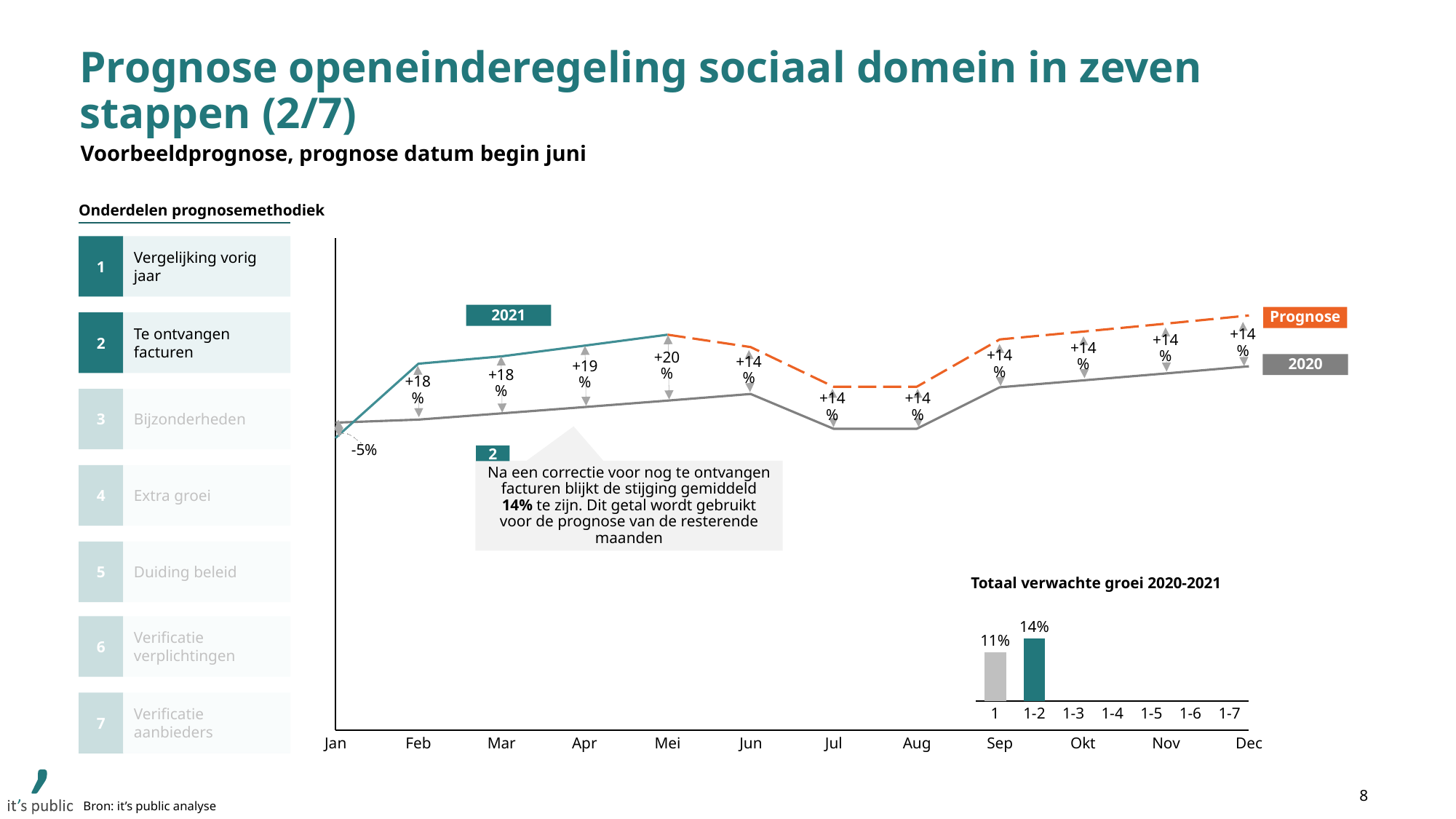
In the line chart, is the labelled percentage difference for Feb larger or smaller than for Mei? smaller In the chart titled 'Totaal verwachte groei 2020-2021', what is the value for category 1-2? 14% In the chart titled 'Totaal verwachte groei 2020-2021', what is the value for category 1? 11% In the line chart, how many months are shown on the x axis? 12 In the line chart, what are the three series labels shown? 2021, Prognose, 2020 In the line chart, which month has the lowest labelled percentage difference? Jan In the chart titled 'Totaal verwachte groei 2020-2021', what is the difference between the values for 1-2 and 1? 3 percentage points In the line chart, what percentage difference is labelled for Jan? -5% What kind of chart is 'Totaal verwachte groei 2020-2021'? bar chart In the line chart, what percentage difference is labelled for Mei? +20% In the line chart, what percentage difference is labelled for Apr? +19% In the line chart, which month has the highest labelled percentage difference? Mei